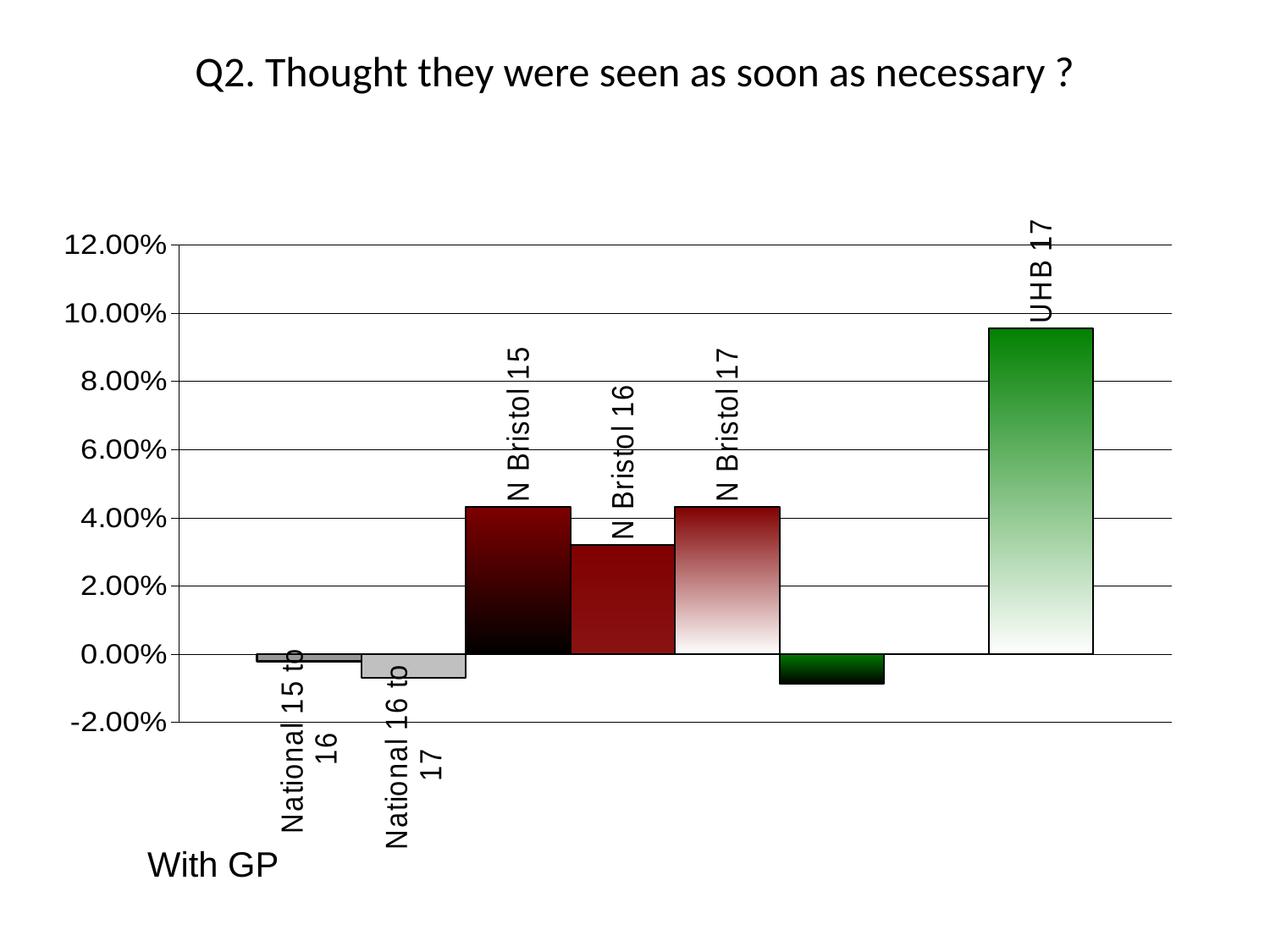
What is the title of the chart? Q2. Thought they were seen as soon as necessary ? Which is larger, the value for N Bristol 15 or N Bristol 16? N Bristol 15 Which category has the highest value? UHB 17 Is the value for UHB 17 greater or less than 8.00%? greater Is the value for N Bristol 15 greater or less than 2.00%? greater What text appears at the bottom left of the chart? With GP How many bars are plotted in the chart? 7 What kind of chart is shown on the slide? bar chart Is the value for N Bristol 16 greater or less than 4.00%? less Which is larger, the value for UHB 17 or N Bristol 17? UHB 17